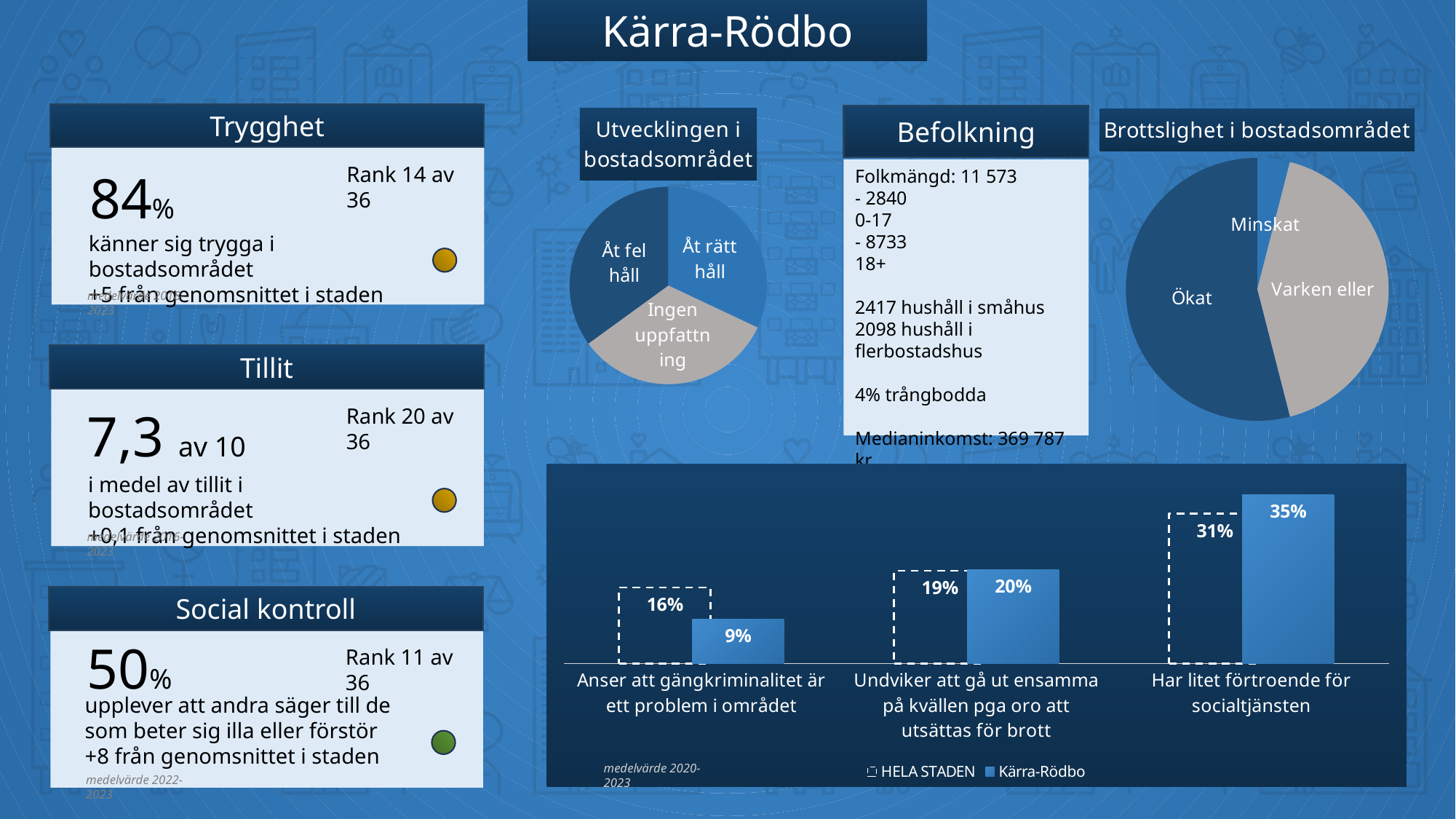
In the bar chart at the bottom of the slide, what is the value for Kärra-Rödbo for "Har litet förtroende för socialtjänsten"? 35% In the bar chart at the bottom of the slide, which is larger for "Har litet förtroende för socialtjänsten": HELA STADEN or Kärra-Rödbo? Kärra-Rödbo How many slices does the pie chart "Utvecklingen i bostadsområdet" have? 3 What kind of chart is "Brottslighet i bostadsområdet"? Pie chart In the bar chart at the bottom of the slide, what is the value for HELA STADEN for "Anser att gängkriminalitet är ett problem i området"? 16% How many categories are shown in the bar chart at the bottom of the slide? 3 In the pie chart "Brottslighet i bostadsområdet", which slice is larger: Ökat or Minskat? Ökat How many series does the legend of the bar chart at the bottom of the slide list? 2 In the bar chart at the bottom of the slide, which category has the highest value for Kärra-Rödbo? Har litet förtroende för socialtjänsten In the bar chart at the bottom of the slide, which category has the lowest value for HELA STADEN? Anser att gängkriminalitet är ett problem i området In the bar chart at the bottom of the slide, what is the value for Kärra-Rödbo for "Undviker att gå ut ensamma på kvällen pga oro att utsättas för brott"? 20% In the bar chart at the bottom of the slide, what is the difference between HELA STADEN and Kärra-Rödbo for "Anser att gängkriminalitet är ett problem i området"? 7%